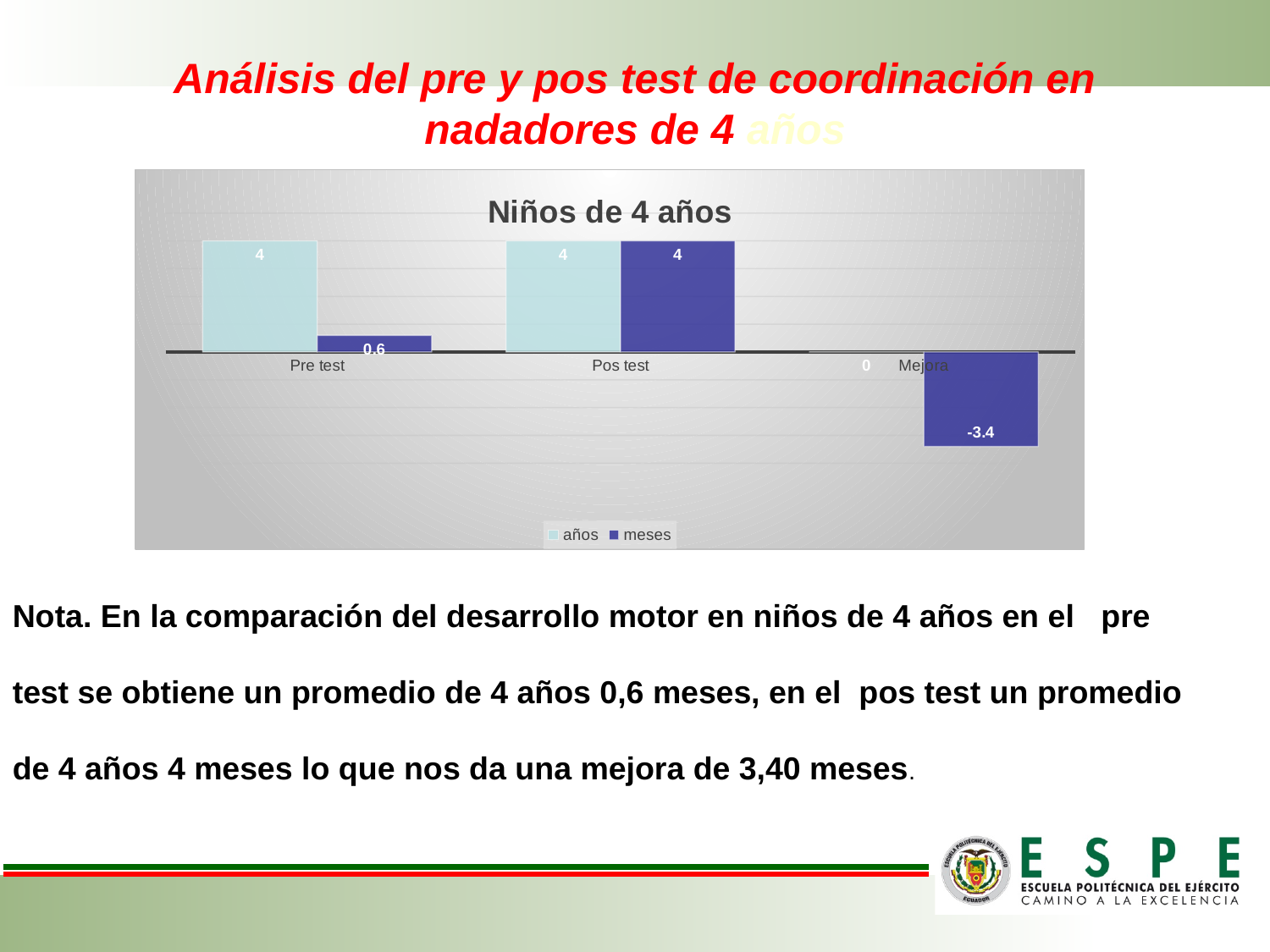
What type of chart is shown on the slide? bar chart What is the value of the 'meses' series for Pos test? 4 Which is larger, the 'meses' value for Pos test or for Pre test? Pos test What is the value of the 'meses' series for Mejora? -3.4 What is the value of the 'meses' series for Pre test? 0.6 What is the value of the 'años' series for Pre test? 4 How many series does the chart legend list? 2 What is the value of the 'años' series for Mejora? 0 How many categories are shown on the x axis of the chart? 3 What is the difference between the 'meses' values for Pos test and Pre test? 3.4 Which category has the lowest value in the 'meses' series? Mejora What is the title of the chart? Niños de 4 años